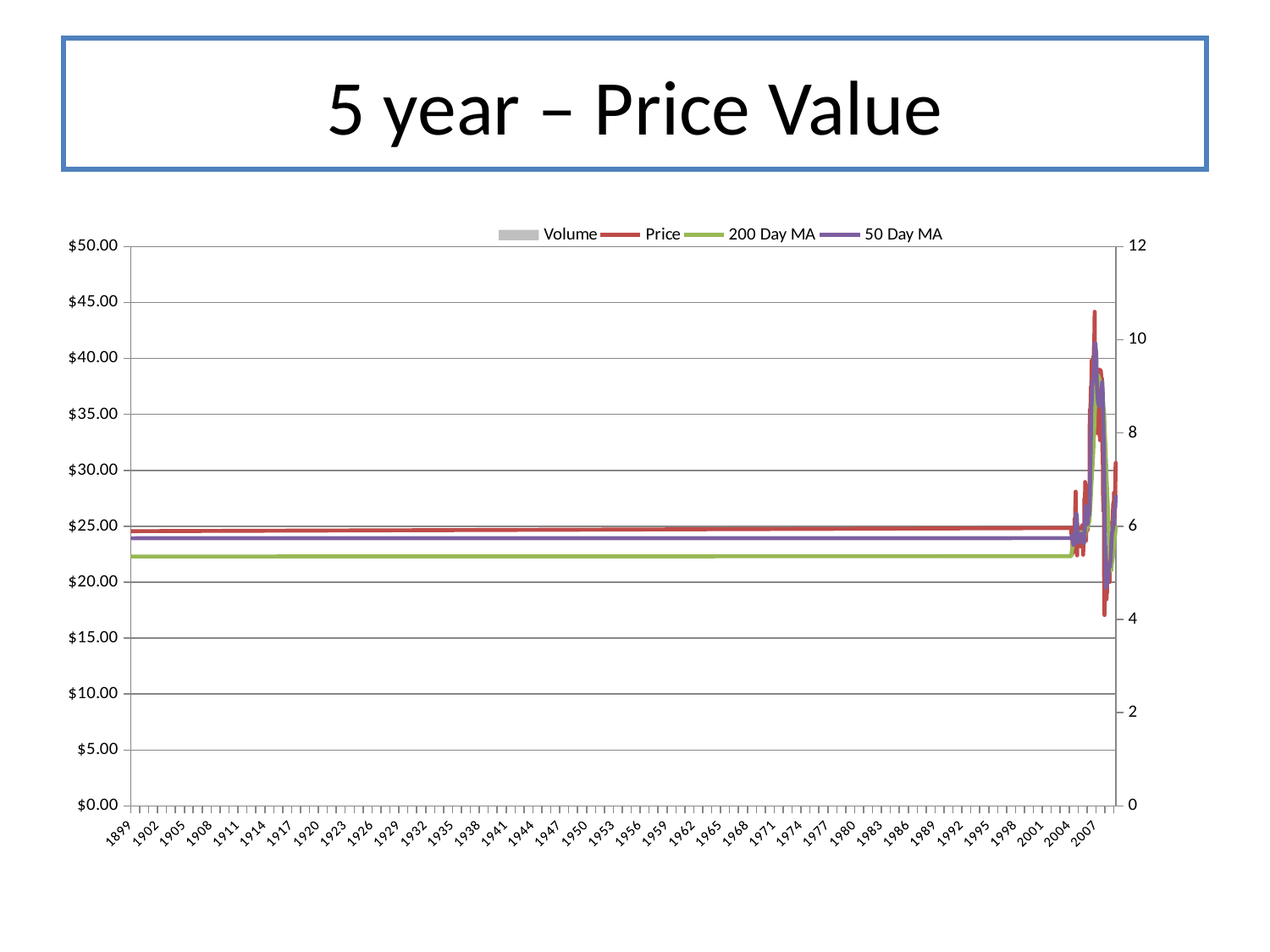
In the flat portion of the chart (e.g. around 1950), which line is higher: Price or 200 Day MA? Price What is the title of the slide containing the chart? 5 year – Price Value What is the first year label on the x axis? 1899 Is the lowest dip of the Price line near the right end of the chart greater or less than $20.00? less Is the value of the Price line across the flat portion of the chart (e.g. around 1950) greater or less than $20.00? greater In the flat portion of the chart (e.g. around 1950), which of the three line series is the lowest? 200 Day MA Is the highest peak of the Price line near the right end of the chart greater or less than $40.00? greater How many series does the legend list? 4 What is the highest value shown on the left vertical axis? $50.00 What kind of chart is shown on the slide? line chart Which series are listed in the chart legend? Volume, Price, 200 Day MA, 50 Day MA